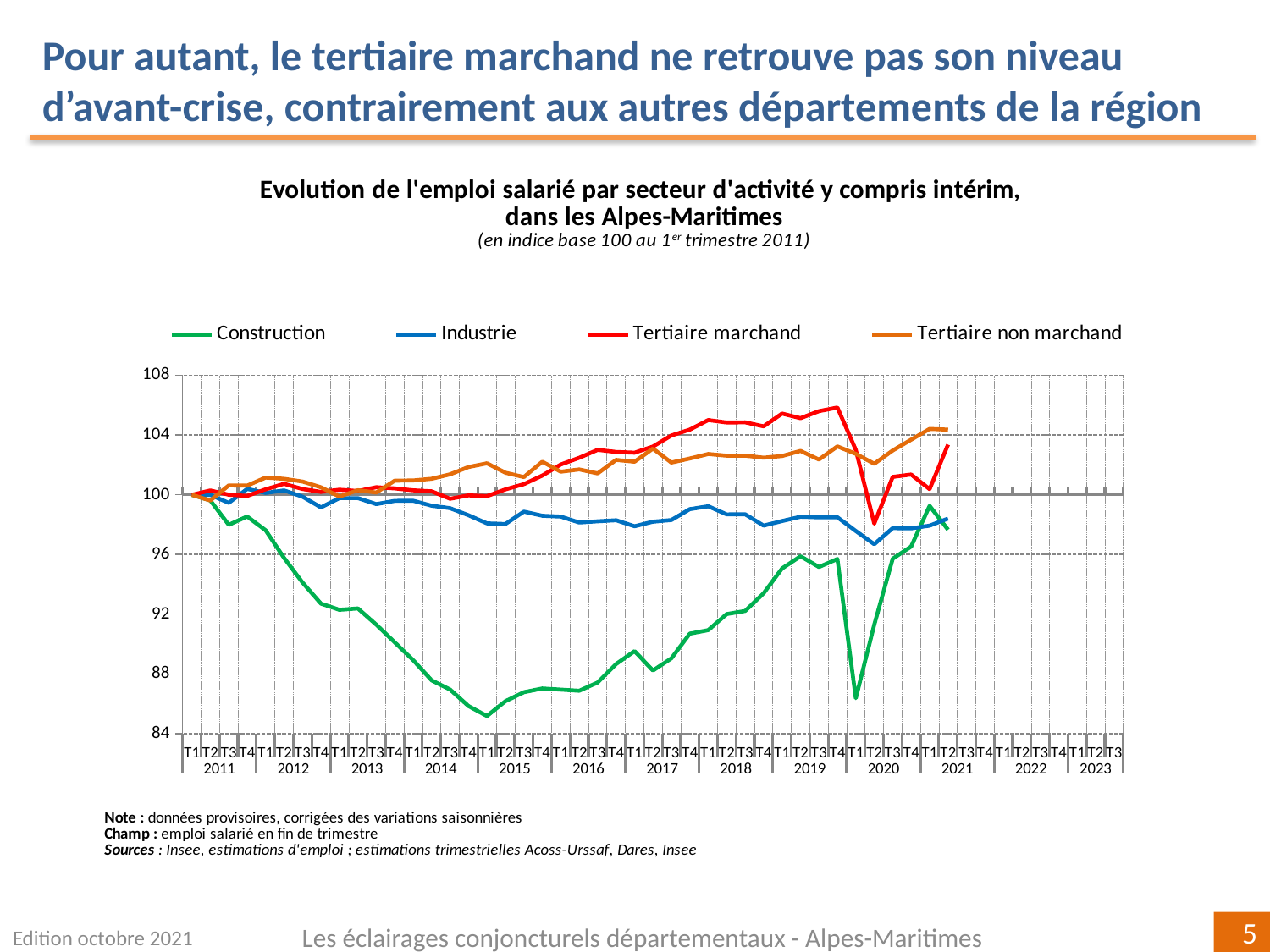
What is the lowest value shown on the vertical axis of the chart? 84 What is the value of every series at T1 2011, the base period of the index? 100 Which series has the lowest value at T1 2020? Construction Which series has the highest value at T4 2019? Tertiaire marchand Is the value for Construction at T1 2020 greater or less than 88? less Is the value for Tertiaire marchand at T4 2019 greater or less than 104? greater Is the value for Industrie at T1 2020 greater or less than 100? less Does the Tertiaire marchand series rise or fall between T1 2015 and T4 2019? rise Does the Construction series rise or fall between T1 2011 and T1 2015? fall What kind of chart is shown on the slide? line chart At T1 2020, which is larger: the value for Construction or the value for Industrie? Industrie How many series does the legend list? 4